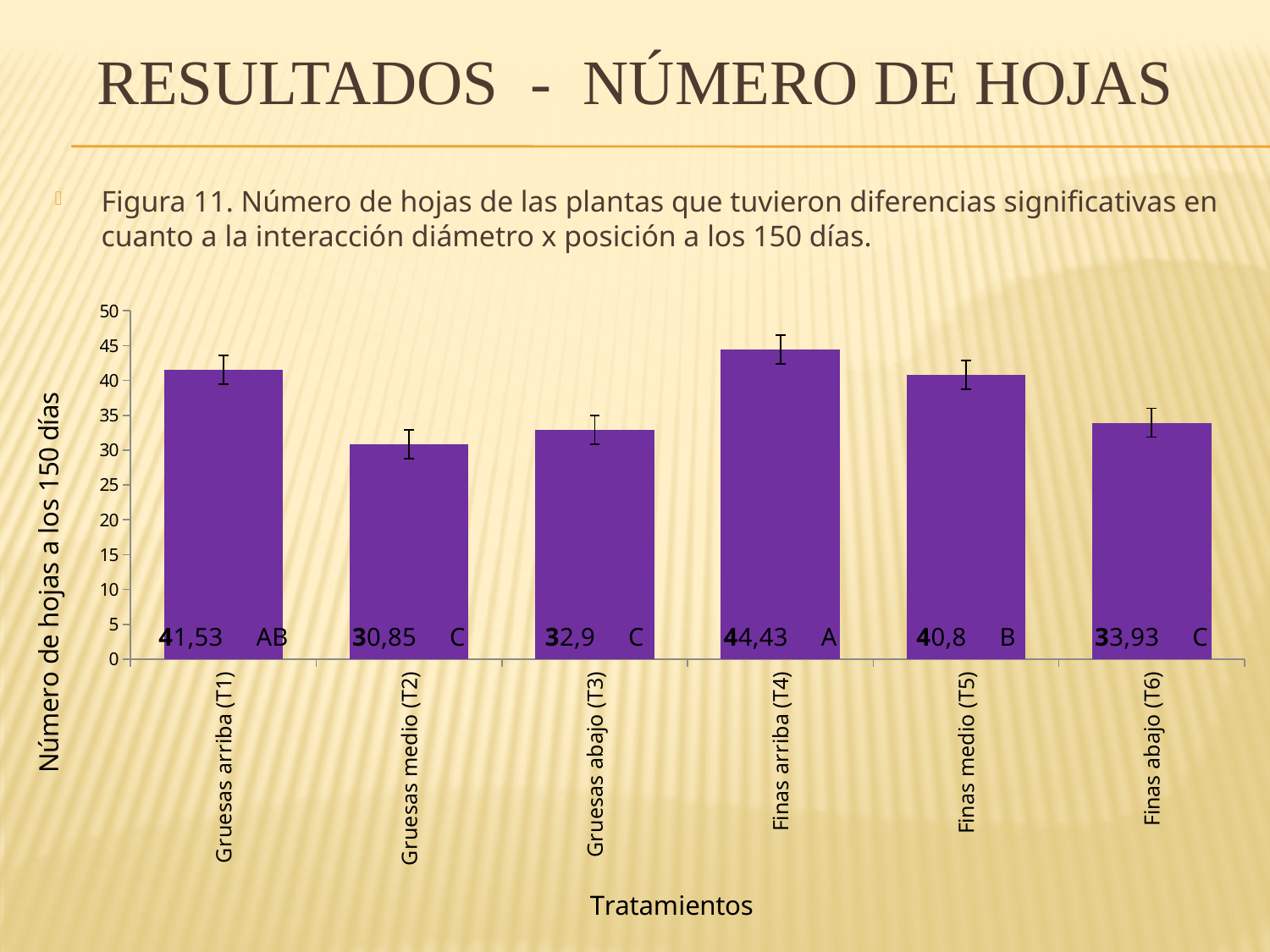
Which is larger, the value for Gruesas arriba (T1) or Finas medio (T5)? Gruesas arriba (T1) What is the value for Gruesas arriba (T1)? 41,53 What is the label of the y axis? Número de hojas a los 150 días What is the difference between the values for Finas abajo (T6) and Gruesas abajo (T3)? 1,03 Which treatment has the highest number of leaves? Finas arriba (T4) How many treatments are shown on the x axis? 6 What kind of chart is shown on the slide? bar chart Which treatment has the lowest number of leaves? Gruesas medio (T2) What is the value for Finas medio (T5)? 40,8 What is the difference between the values for Finas arriba (T4) and Gruesas medio (T2)? 13,58 Is the value for Finas abajo (T6) greater or less than 35? less What is the value for Gruesas abajo (T3)? 32,9